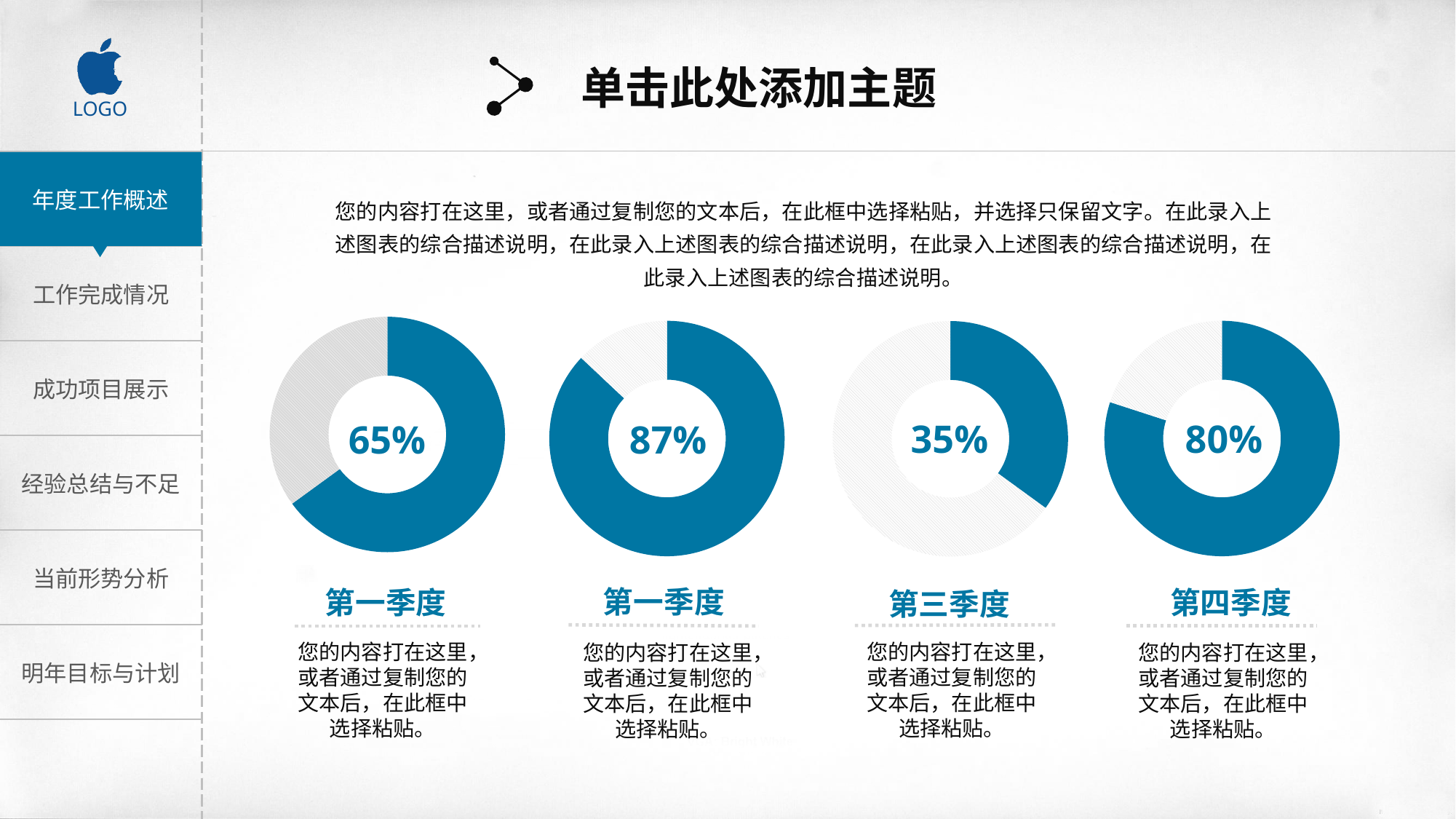
What value is shown in the donut chart labelled 第四季度? 80% Which of the four donut charts shows the highest percentage? The second from the left (87%) What is the difference between the value in the second donut chart from the left (87%) and the value in the 第三季度 chart? 52% Which is larger, the value in the 第四季度 chart or the value in the leftmost chart? 第四季度 (80%) How many donut charts are shown on the slide? 4 What type of chart is used to display the quarterly percentages on this slide? Donut (pie) chart Which of the four donut charts shows the lowest percentage? 第三季度 (35%) What value is shown in the centre of the leftmost donut chart (labelled 第一季度)? 65% What value is shown in the centre of the second donut chart from the left? 87% What is the difference between the 第四季度 chart value and the leftmost chart value? 15% What value is shown in the donut chart labelled 第三季度? 35% What colour is used for the filled portion of each donut chart? Blue